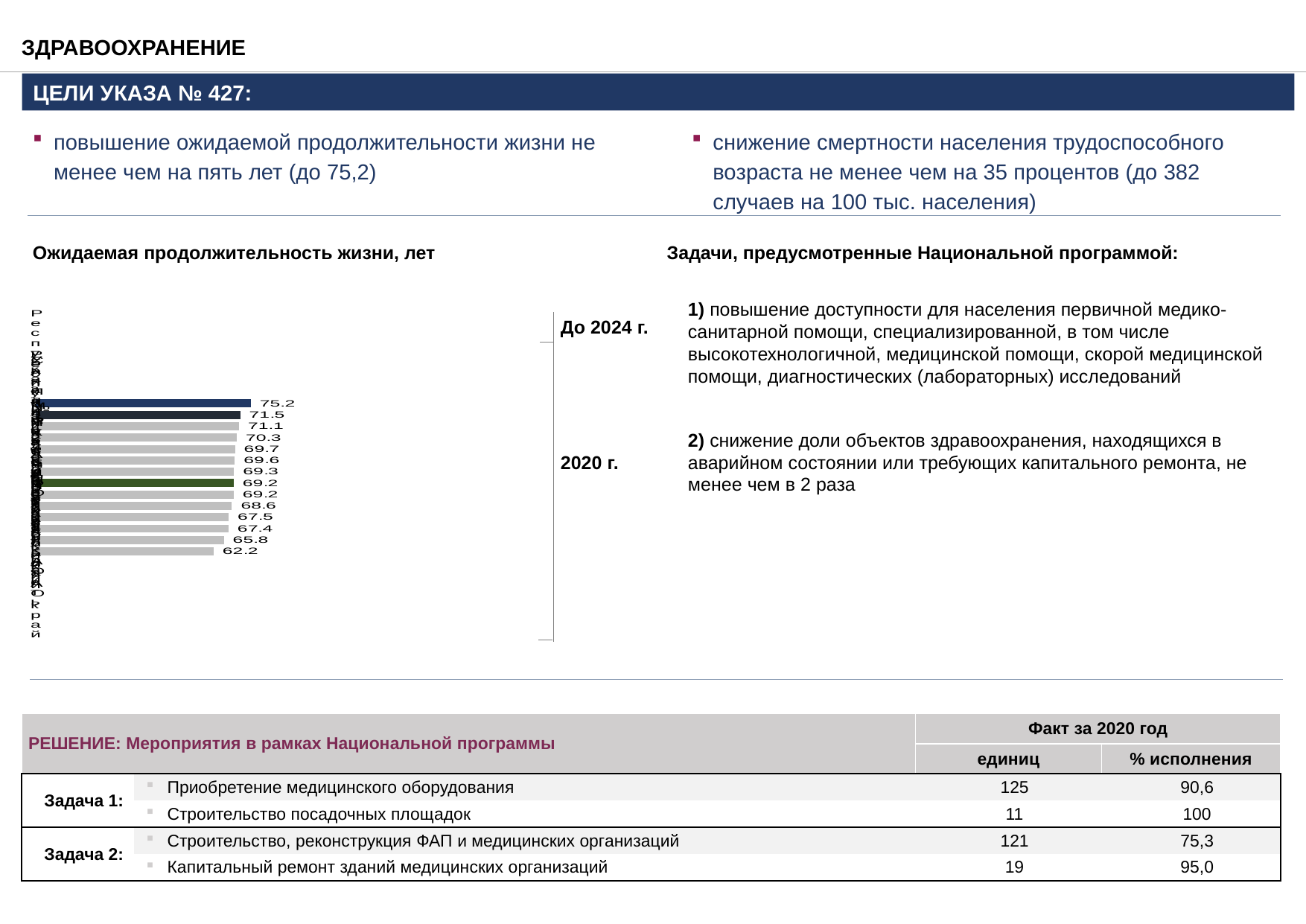
What is the difference between the highest and lowest values in the 'Ожидаемая продолжительность жизни, лет' chart? 13.0 What value is labelled on the green bar in the 'Ожидаемая продолжительность жизни, лет' chart? 69.2 What kind of chart is used to show 'Ожидаемая продолжительность жизни, лет'? bar chart What is the second-highest value in the 'Ожидаемая продолжительность жизни, лет' chart? 71.5 Do the bar values in the 'Ожидаемая продолжительность жизни, лет' chart increase or decrease from top to bottom? decrease What is the difference between the second-highest and third-highest values in the 'Ожидаемая продолжительность жизни, лет' chart? 0.4 What is the lowest value shown in the 'Ожидаемая продолжительность жизни, лет' chart? 62.2 What is the highest value shown in the 'Ожидаемая продолжительность жизни, лет' chart? 75.2 What is the title of the bar chart on the slide? Ожидаемая продолжительность жизни, лет What colour is the topmost bar (75.2) in the 'Ожидаемая продолжительность жизни, лет' chart? dark blue How many bars in the 'Ожидаемая продолжительность жизни, лет' chart are labelled 69.2? 2 How many bars are plotted in the 'Ожидаемая продолжительность жизни, лет' chart? 14